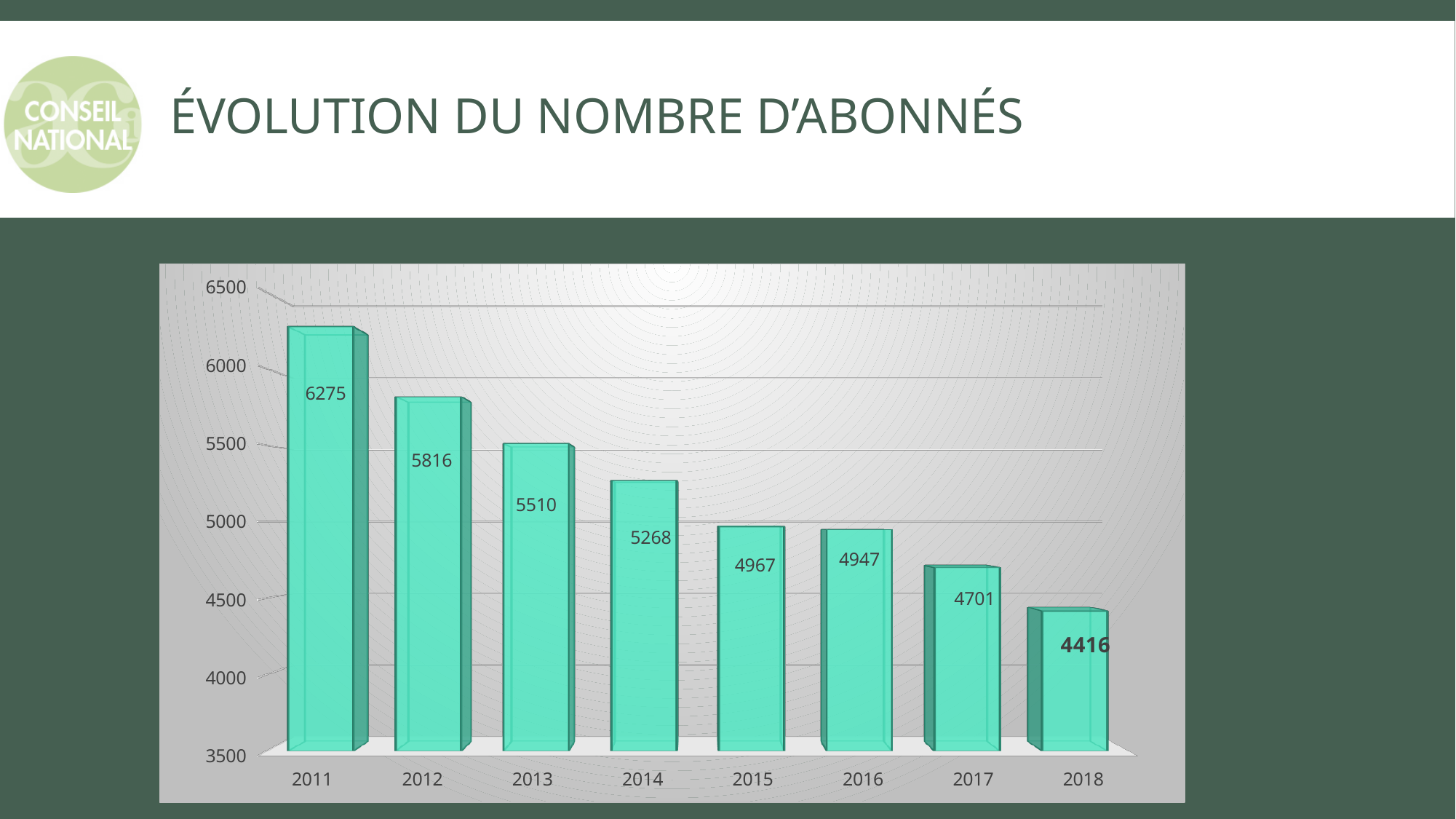
How many years are shown on the x axis? 8 What is the difference between the values for 2012 and 2013? 306 Which year has the highest value? 2011 What is the value for 2018? 4416 Is the value for 2016 greater or less than 5000? less What is the value for 2014? 5268 What kind of chart is shown on the slide? bar chart Do the values rise or fall from 2011 to 2018? fall Which is larger, the value for 2015 or the value for 2017? 2015 What is the difference between the values for 2011 and 2018? 1859 Which year has the lowest value? 2018 What is the value for 2011? 6275